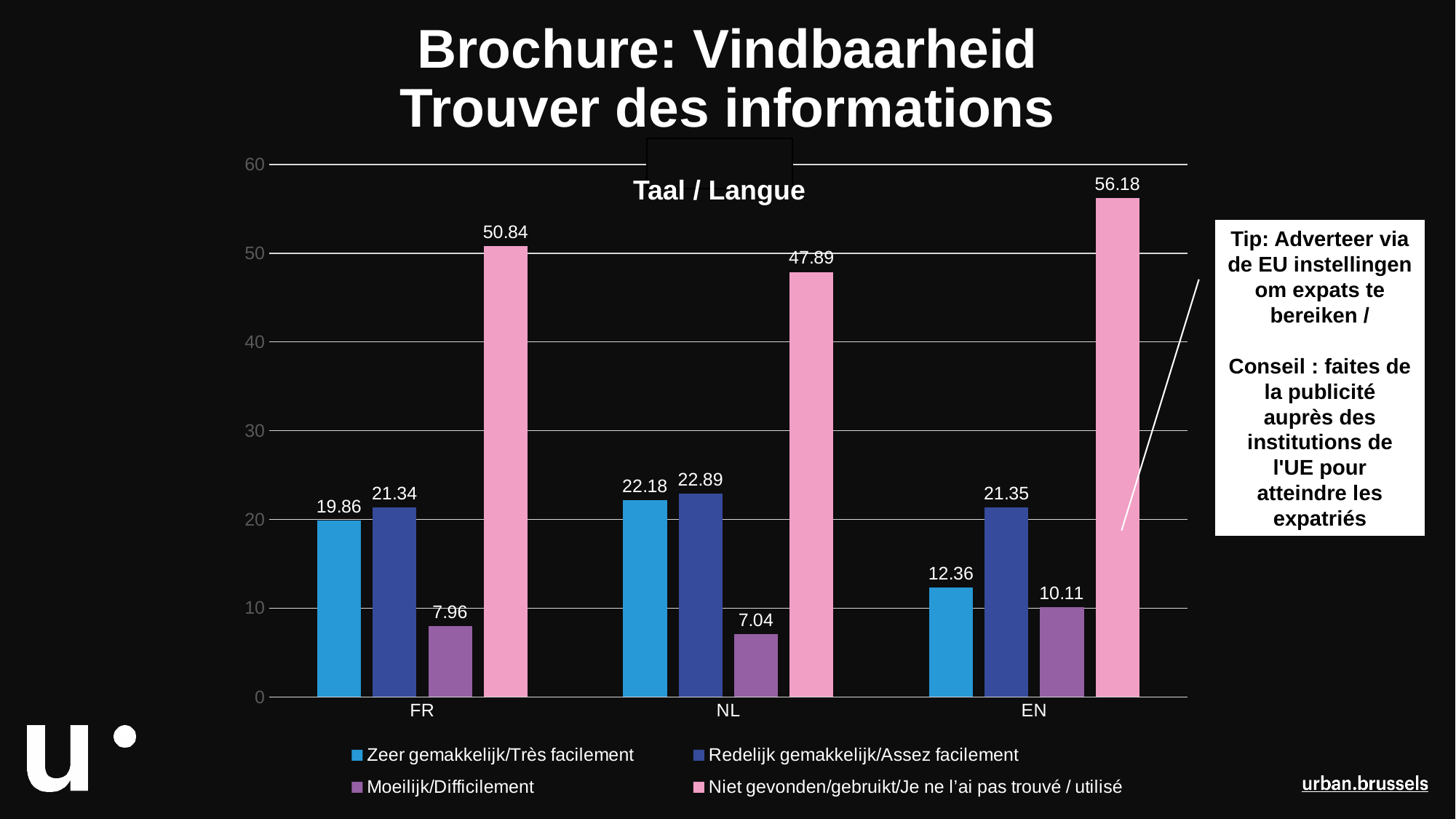
What kind of chart is shown on the slide? Bar chart What is the value for 'Niet gevonden/gebruikt/Je ne l'ai pas trouvé / utilisé' for EN? 56.18 Which language has the lowest value for 'Zeer gemakkelijk/Très facilement'? EN What is the value for 'Zeer gemakkelijk/Très facilement' for NL? 22.18 How many series does the legend list? 4 Which language has the highest value for 'Niet gevonden/gebruikt/Je ne l'ai pas trouvé / utilisé'? EN Is the value for 'Niet gevonden/gebruikt/Je ne l'ai pas trouvé / utilisé' for FR greater or less than 40? greater What is the difference between the 'Niet gevonden/gebruikt/Je ne l'ai pas trouvé / utilisé' values for EN and NL? 8.29 Which is larger: the 'Moeilijk/Difficilement' value for EN or for NL? EN What is the value for 'Redelijk gemakkelijk/Assez facilement' for EN? 21.35 What is the value for 'Moeilijk/Difficilement' for FR? 7.96 How many language categories are shown on the x axis? 3